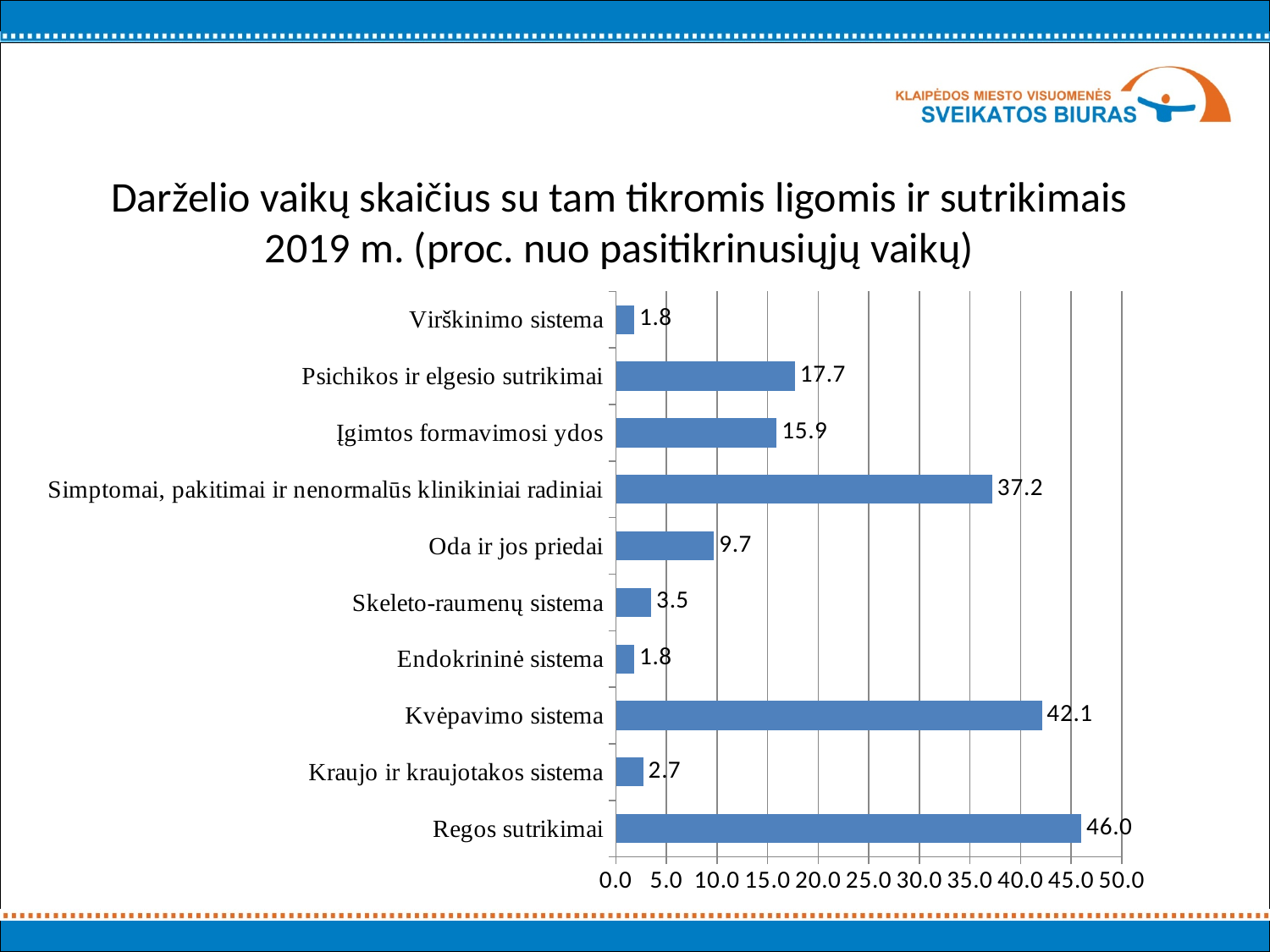
What is the value for Regos sutrikimai? 46.0 What is the value for Simptomai, pakitimai ir nenormalūs klinikiniai radiniai? 37.2 What is the difference between the values for Regos sutrikimai and Kvėpavimo sistema? 3.9 How many categories are shown in the chart? 10 What is the title of the chart? Darželio vaikų skaičius su tam tikromis ligomis ir sutrikimais 2019 m. (proc. nuo pasitikrinusiųjų vaikų) What is the difference between the values for Psichikos ir elgesio sutrikimai and Skeleto-raumenų sistema? 14.2 Which category has the highest value? Regos sutrikimai What kind of chart is shown on the slide? bar chart What is the value for Oda ir jos priedai? 9.7 Which is larger, the value for Psichikos ir elgesio sutrikimai or the value for Įgimtos formavimosi ydos? Psichikos ir elgesio sutrikimai Is the value for Simptomai, pakitimai ir nenormalūs klinikiniai radiniai greater or less than 35.0? greater What is the value for Kvėpavimo sistema? 42.1